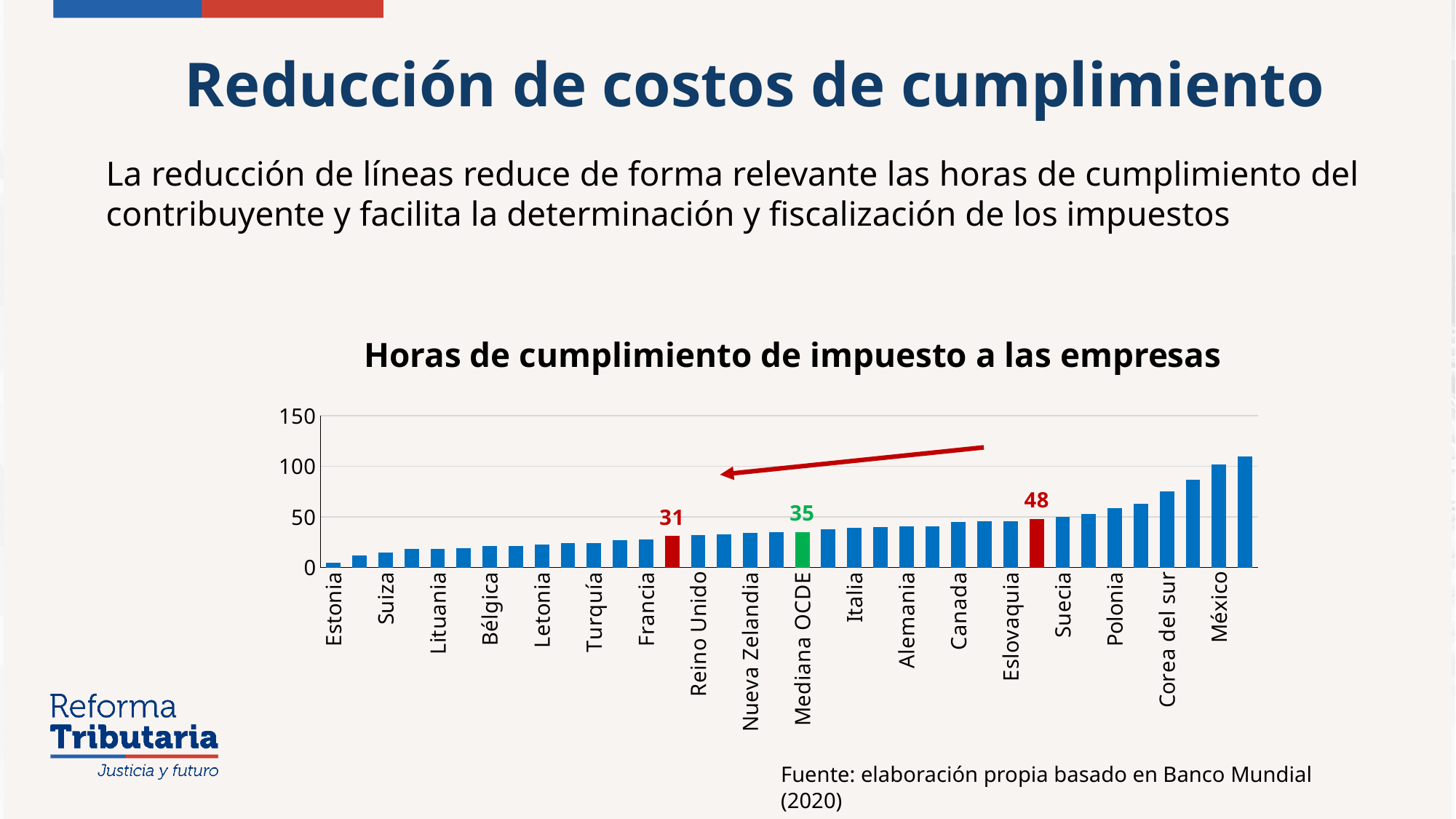
Do the values generally rise or fall from left to right along the x axis? rise What value is labelled on the red bar between Francia and Reino Unido? 31 Which has the larger value, México or Estonia? México What is the value for Mediana OCDE? 35 What value is labelled on the red bar between Eslovaquia and Suecia? 48 What colour is the Mediana OCDE bar? green What is the difference between the two red-labelled values, 48 and 31? 17 How much higher is the red bar labelled 48 than the Mediana OCDE value? 13 Is the value for Corea del sur greater or less than 100? less What is the title of the chart? Horas de cumplimiento de impuesto a las empresas Which labelled country has the lowest value? Estonia What kind of chart is shown on the slide? bar chart